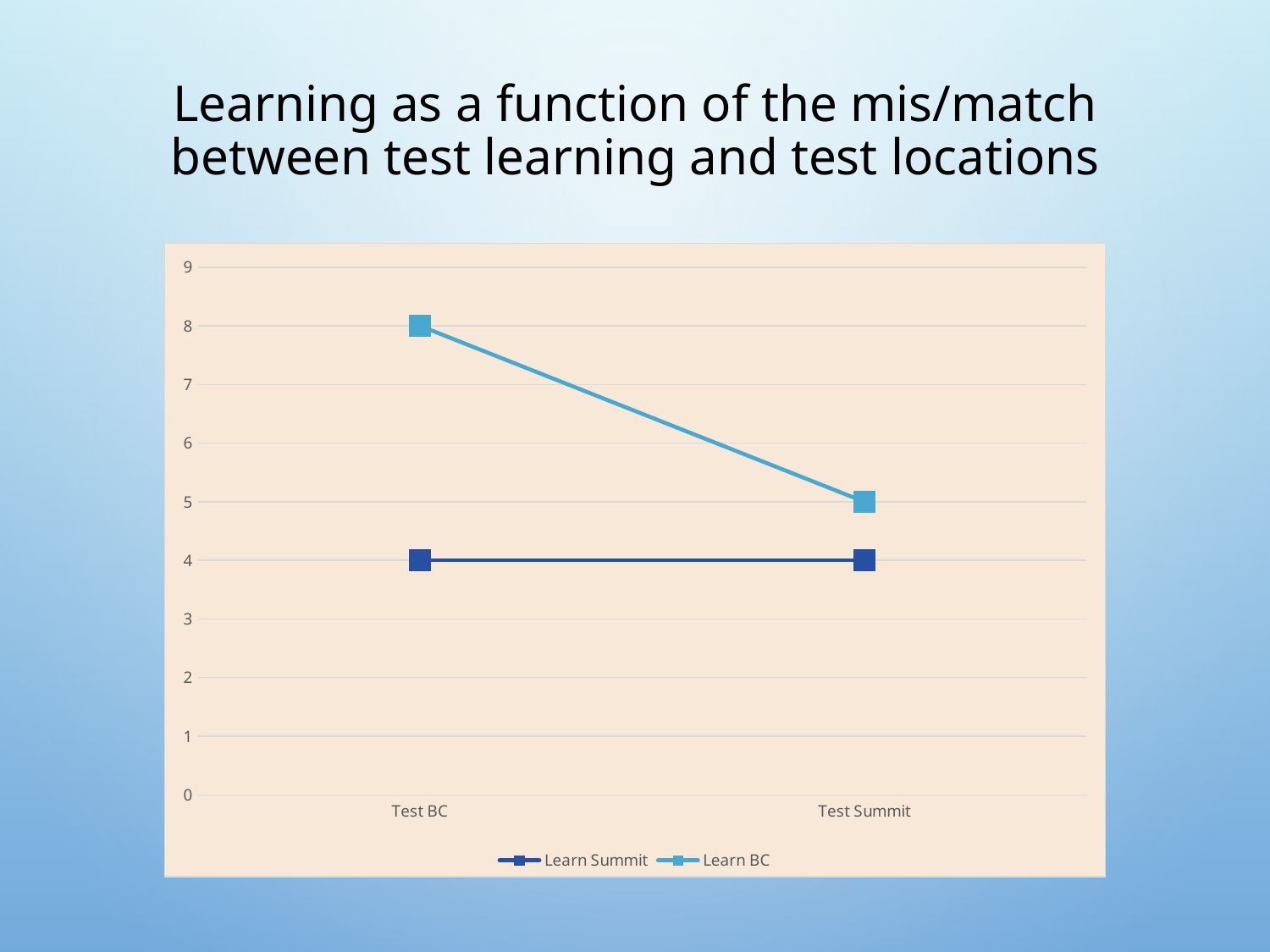
Which series has the higher value at Test BC? Learn BC How many series does the legend list? 2 What is the value for Learn BC at Test BC? 8 Is the value for Learn BC at Test Summit greater or less than 6? less What is the value for Learn Summit at Test BC? 4 Does the Learn BC line rise or fall from Test BC to Test Summit? Fall What is the value for Learn BC at Test Summit? 5 How many categories are shown on the x axis? 2 What is the title of the slide? Learning as a function of the mis/match between test learning and test locations What kind of chart is shown on the slide? Line chart What is the difference between the Learn BC values at Test BC and Test Summit? 3 What is the value for Learn Summit at Test Summit? 4